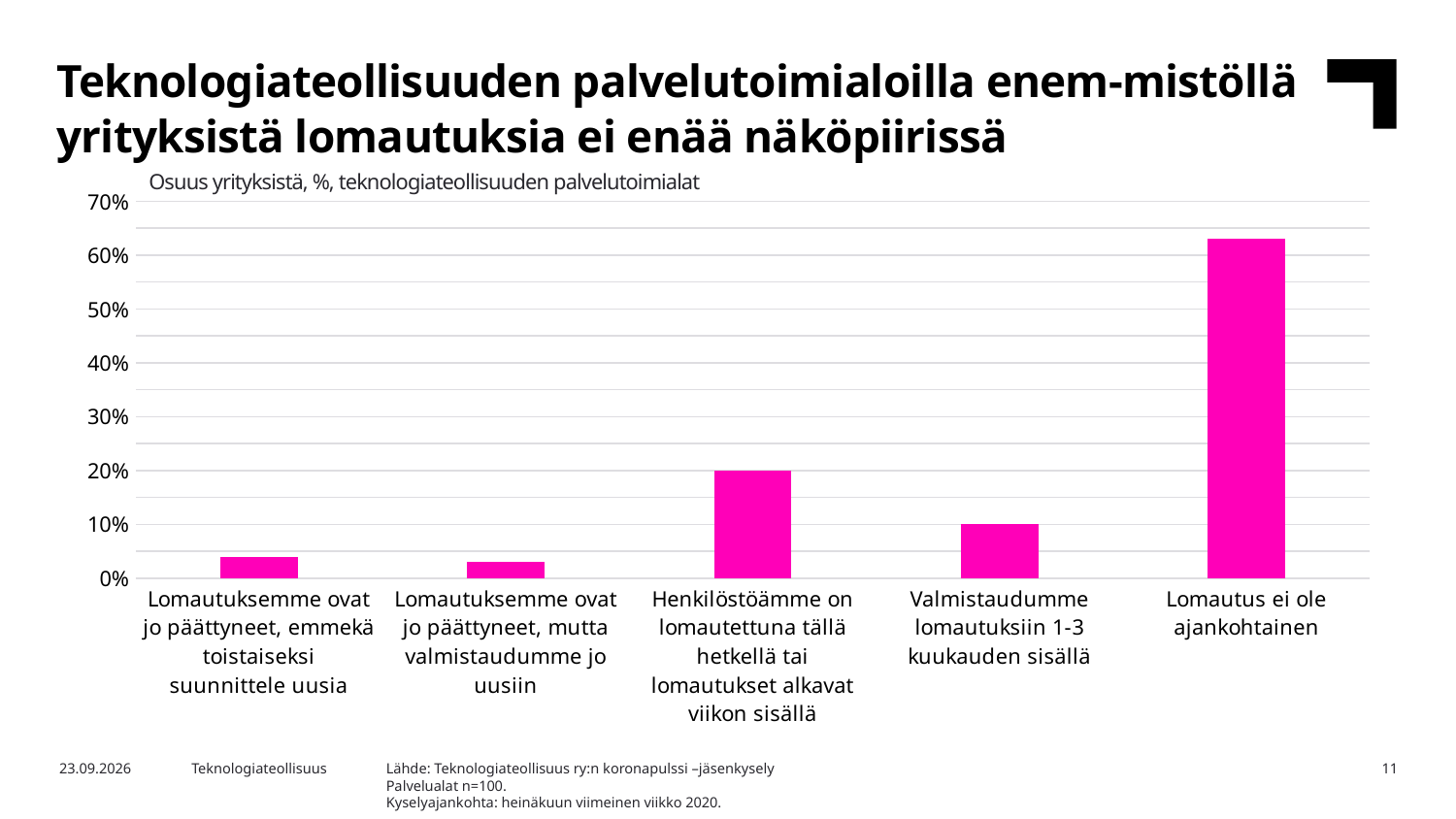
Is the value for "Lomautus ei ole ajankohtainen" greater or less than 60%? greater Is the value for "Lomautuksemme ovat jo päättyneet, emmekä toistaiseksi suunnittele uusia" greater or less than 10%? less Which is larger: the value for "Henkilöstöämme on lomautettuna tällä hetkellä tai lomautukset alkavat viikon sisällä" or the value for "Valmistaudumme lomautuksiin 1-3 kuukauden sisällä"? Henkilöstöämme on lomautettuna tällä hetkellä tai lomautukset alkavat viikon sisällä What colour are the bars in the chart? magenta (pink) What is the value for "Valmistaudumme lomautuksiin 1-3 kuukauden sisällä"? 10% What is the value for "Henkilöstöämme on lomautettuna tällä hetkellä tai lomautukset alkavat viikon sisällä"? 20% Which category has the highest value in the chart? Lomautus ei ole ajankohtainen How many categories are shown on the x axis of the chart? 5 Is the value for "Lomautuksemme ovat jo päättyneet, mutta valmistaudumme jo uusiin" greater or less than 10%? less What is the difference between the values for "Henkilöstöämme on lomautettuna tällä hetkellä tai lomautukset alkavat viikon sisällä" and "Valmistaudumme lomautuksiin 1-3 kuukauden sisällä"? 10% What is the title of the chart? Osuus yrityksistä, %, teknologiateollisuuden palvelutoimialat What kind of chart is shown on the slide? bar chart